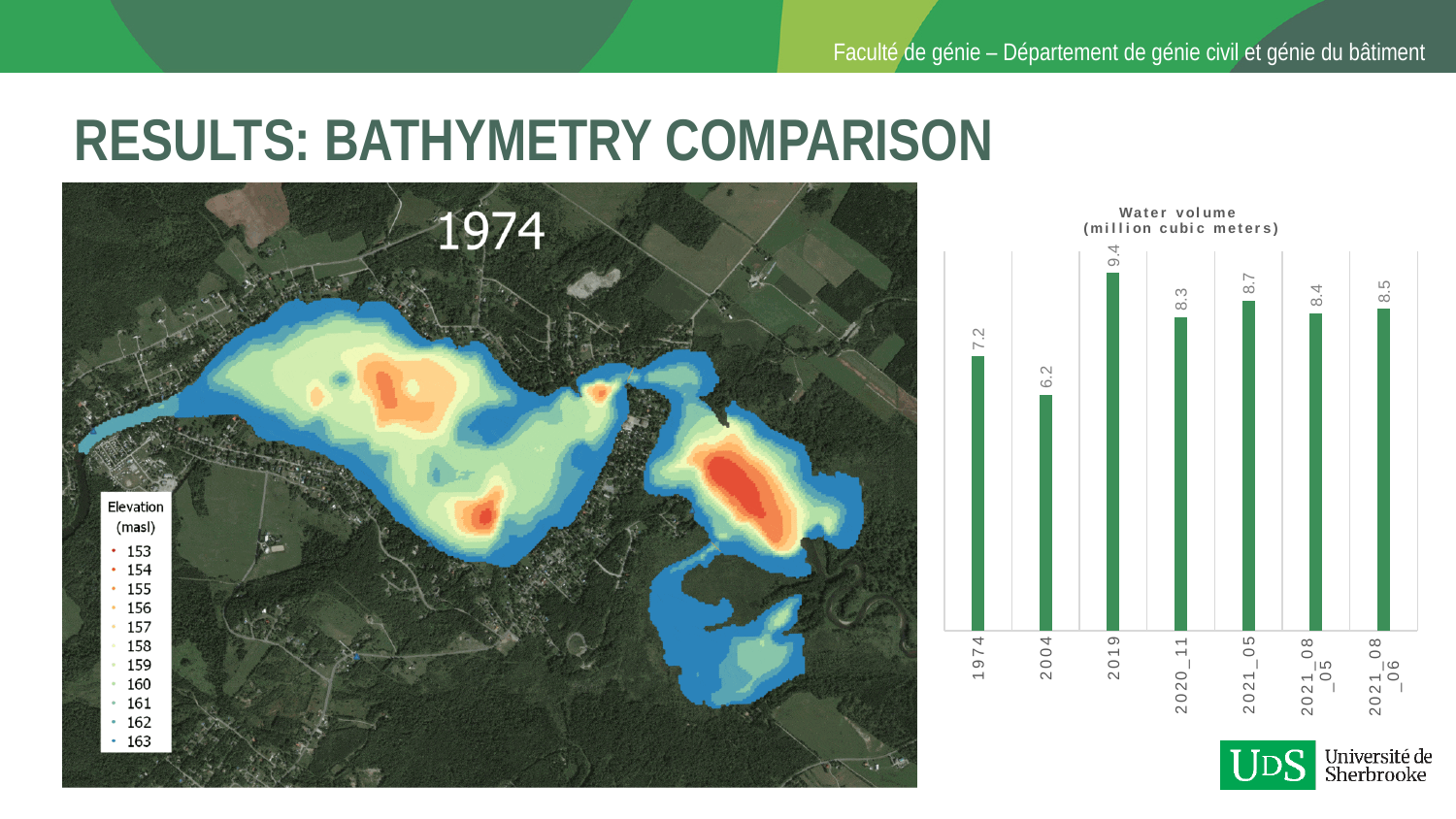
Which has a larger water volume in the bar chart, 2020_11 or 2021_05? 2021_05 What is the difference in water volume between 2019 and 2004 in the bar chart? 3.2 Which category has the highest water volume in the bar chart? 2019 What is the water volume for 1974 in the bar chart? 7.2 What is the water volume for 2004 in the bar chart? 6.2 What kind of chart is used to show water volume? bar chart What is the difference in water volume between 2021_08_06 and 2021_08_05 in the bar chart? 0.1 How many categories are shown in the water volume bar chart? 7 What is the water volume for 2019 in the bar chart? 9.4 What is the title of the bar chart on the right of the slide? Water volume (million cubic meters) Which category has the lowest water volume in the bar chart? 2004 What is the water volume for 2021_05 in the bar chart? 8.7